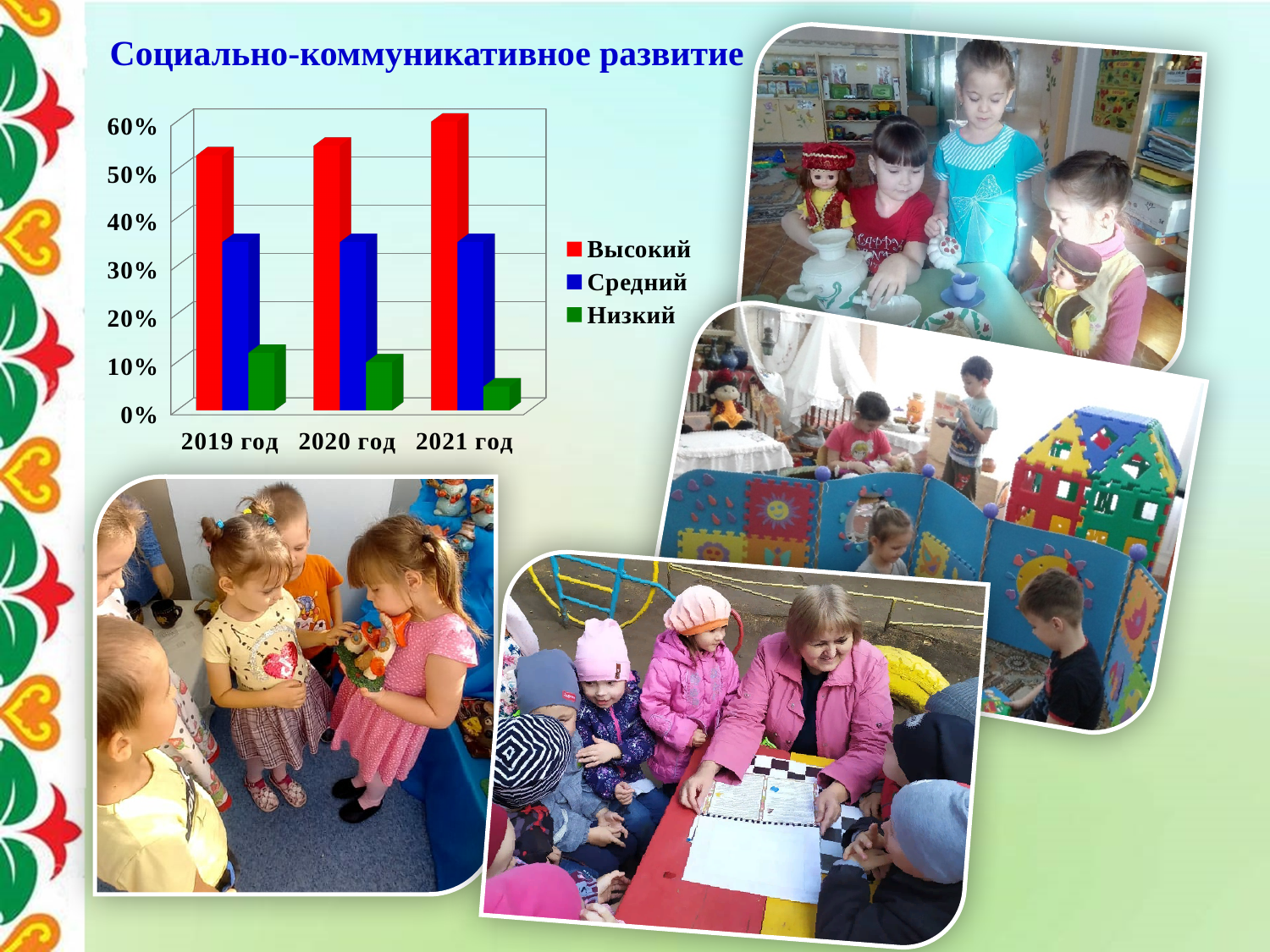
Does the Низкий series rise or fall from 2019 год to 2021 год? fall Is the value for Низкий in 2021 год greater or less than 10%? less Is the value for Высокий in 2021 год greater or less than 50%? greater How many series does the chart legend list? 3 Which series has the highest value in 2021 год? Высокий Is the value for Средний in 2020 год greater or less than 30%? greater Which is larger: the Высокий value in 2019 год or in 2021 год? 2021 год What kind of chart is shown on the slide? bar chart Which series has the lowest value in 2019 год? Низкий What colour represents the Высокий series in the chart? red How many years (categories) are shown on the x axis of the chart? 3